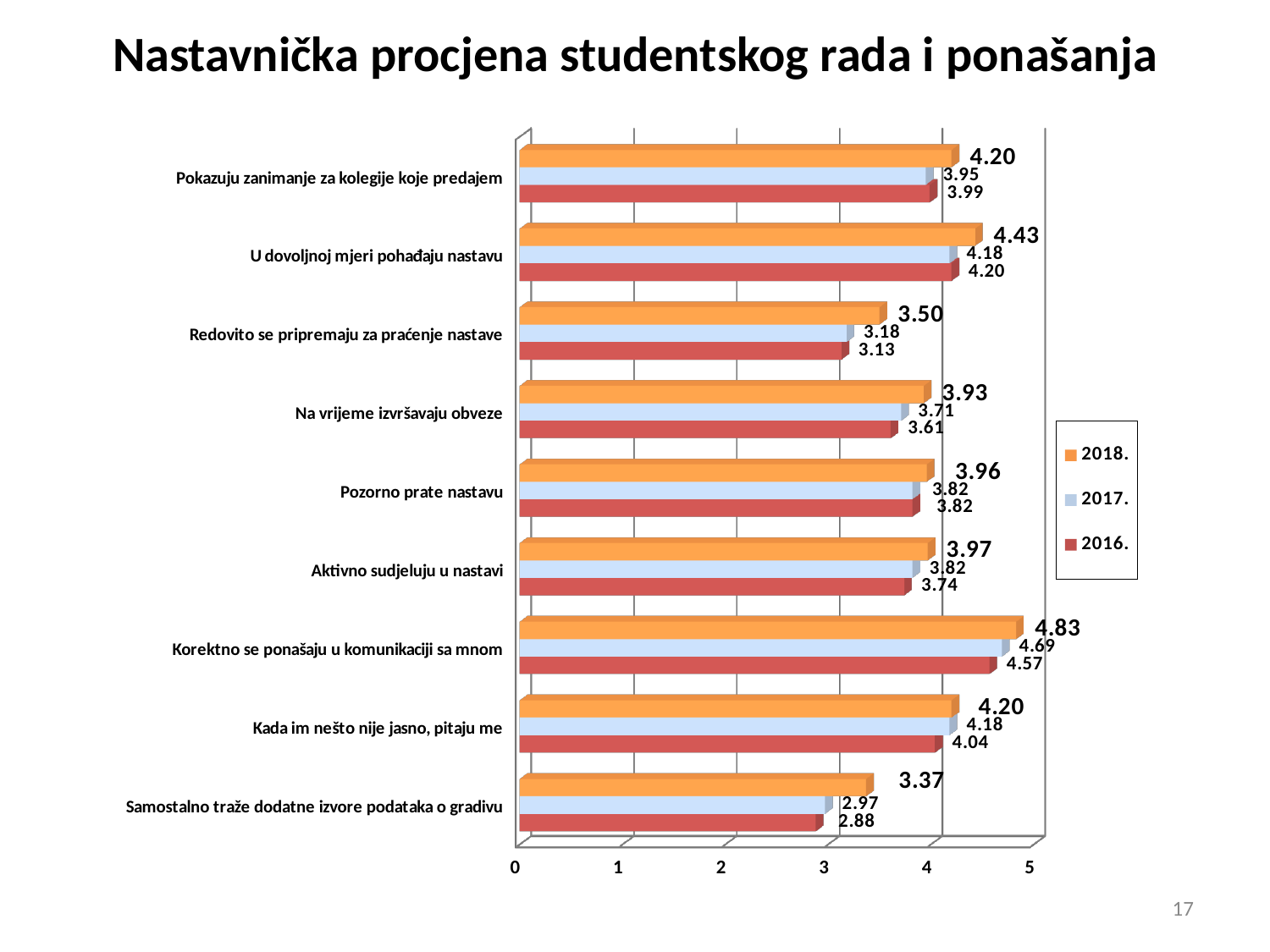
Which category has the lowest 2017. value? Samostalno traže dodatne izvore podataka o gradivu Which is larger for "Pokazuju zanimanje za kolegije koje predajem": the 2017. value or the 2016. value? 2016. What kind of chart is shown on the slide? bar chart How many series does the legend list? 3 Which category has the highest 2018. value? Korektno se ponašaju u komunikaciji sa mnom What is the title of the chart? Nastavnička procjena studentskog rada i ponašanja What is the difference between the 2018. and 2016. values for "U dovoljnoj mjeri pohađaju nastavu"? 0.23 What is the 2016. value for "Samostalno traže dodatne izvore podataka o gradivu"? 2.88 Is the 2018. value for "Redovito se pripremaju za praćenje nastave" greater or less than 4? less How many categories are shown on the chart? 9 What is the 2018. value for "Korektno se ponašaju u komunikaciji sa mnom"? 4.83 What is the 2017. value for "Redovito se pripremaju za praćenje nastave"? 3.18